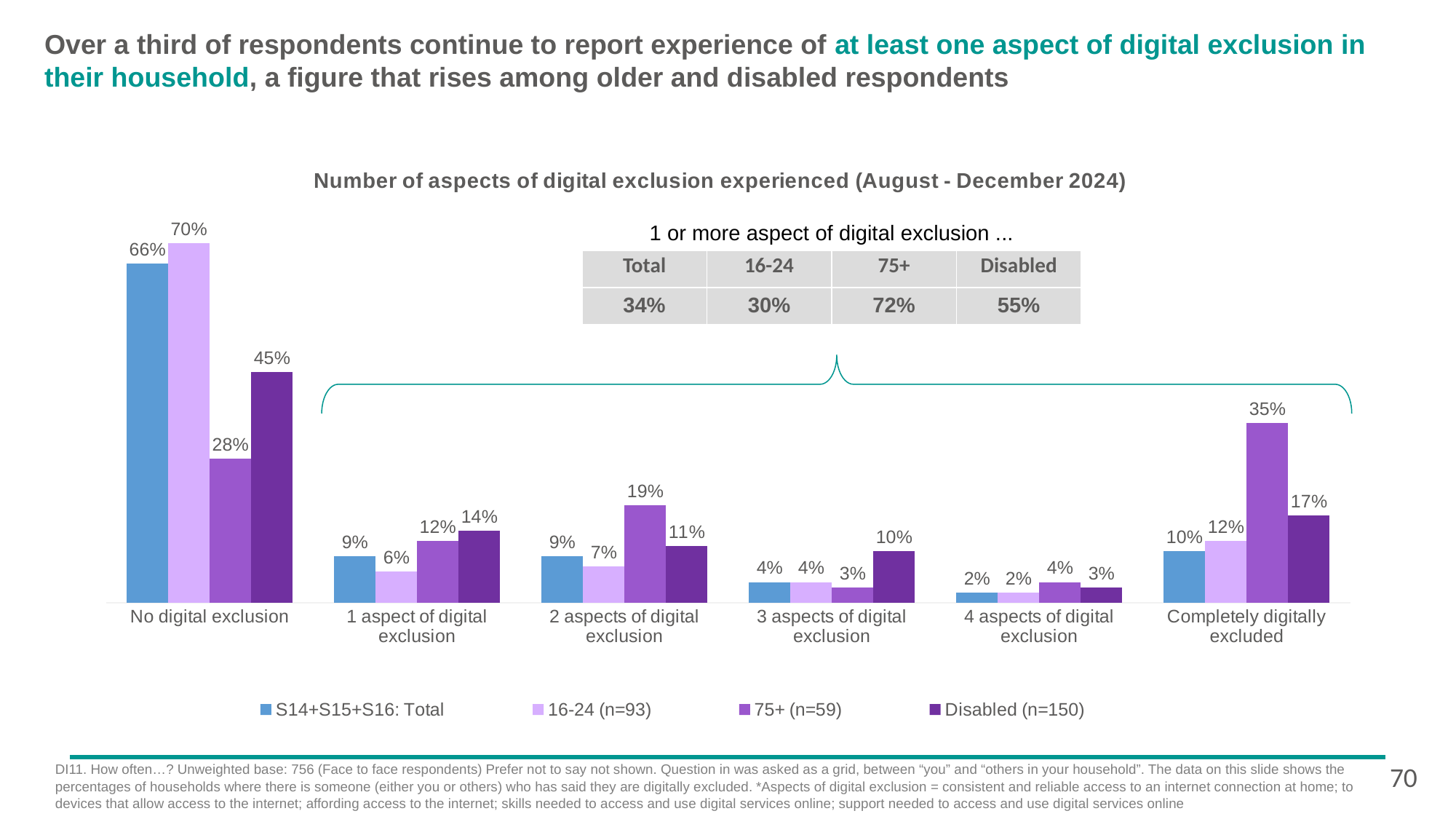
What kind of chart is shown on the slide? Bar chart Which series has the highest value in the 'Completely digitally excluded' category? 75+ (n=59) What is the value for the 75+ (n=59) series in the 'No digital exclusion' category? 28% How many categories are shown on the x axis of the chart? 6 What is the difference between the 16-24 (n=93) and 75+ (n=59) values in the 'No digital exclusion' category? 42 percentage points How many series does the legend list? 4 What is the title of the chart? Number of aspects of digital exclusion experienced (August - December 2024) What is the value for the S14+S15+S16: Total series in the '2 aspects of digital exclusion' category? 9% Which series has the lowest value in the 'No digital exclusion' category? 75+ (n=59) According to the table on the slide, what percentage of 75+ respondents report 1 or more aspect of digital exclusion? 72% What is the value for the Disabled (n=150) series in the 'Completely digitally excluded' category? 17% In the '1 aspect of digital exclusion' category, which is larger: the value for 16-24 (n=93) or the value for Disabled (n=150)? Disabled (n=150)